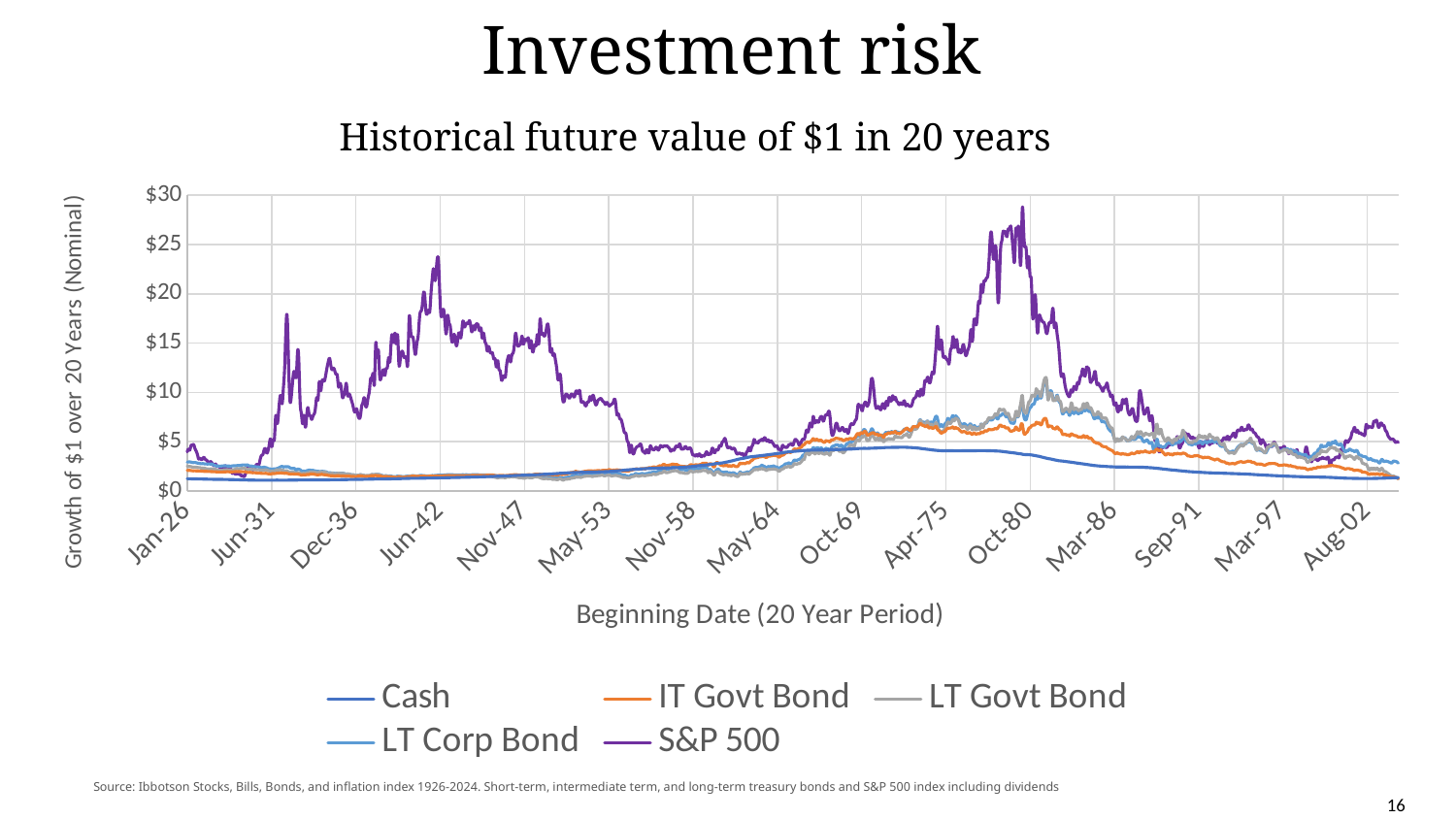
What is the title of the chart? Historical future value of $1 in 20 years What kind of chart is shown on the slide? Line chart Which series reaches the highest value on the chart? S&P 500 Is the value of the S&P 500 series around Nov-58 greater or less than $10? less Around Oct-80, which series has the larger value, S&P 500 or Cash? S&P 500 Is the value of the S&P 500 series at its peak near Jun-42 greater or less than $20? greater Is the peak value of the S&P 500 series greater or less than $25? greater What is the label of the x axis? Beginning Date (20 Year Period) Does the Cash series rise or fall between Oct-69 and Aug-02? fall How many series does the legend list? 5 How many date labels are shown on the x axis? 15